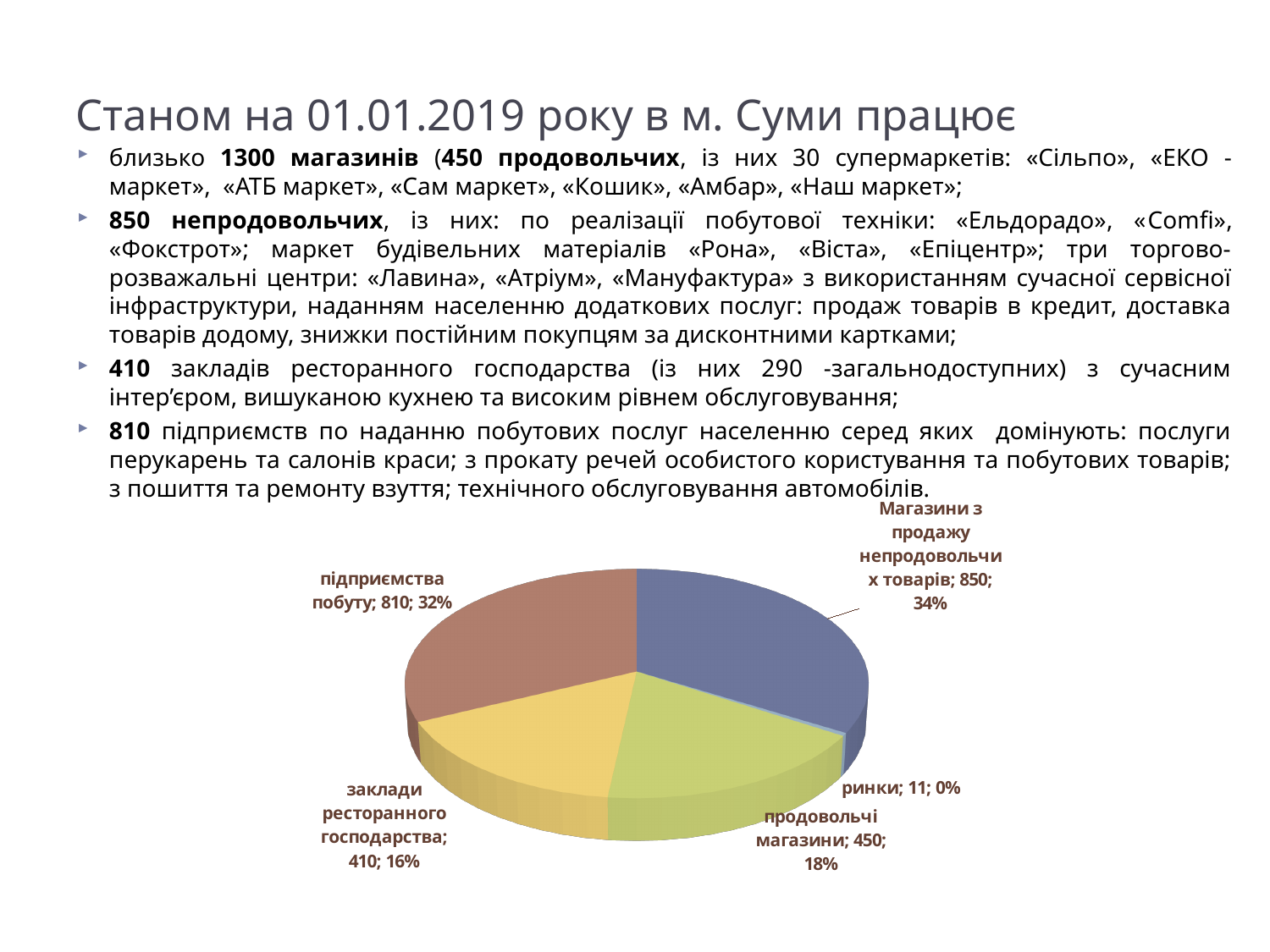
What share of the pie do "підприємства побуту" represent? 32% Which category has the smallest slice of the pie? ринки How many slices does the pie chart have? 5 Which is larger: the value for "продовольчі магазини" or for "заклади ресторанного господарства"? продовольчі магазини What is the total of all values shown in the pie chart? 2531 What kind of chart is shown on the slide? pie chart What share of the pie do "продовольчі магазини" represent? 18% What is the value for "Магазини з продажу непродовольчих товарів"? 850 What is the value for "заклади ресторанного господарства"? 410 What is the value for "ринки"? 11 Which category has the largest slice of the pie? Магазини з продажу непродовольчих товарів What is the difference between the values for "Магазини з продажу непродовольчих товарів" and "підприємства побуту"? 40